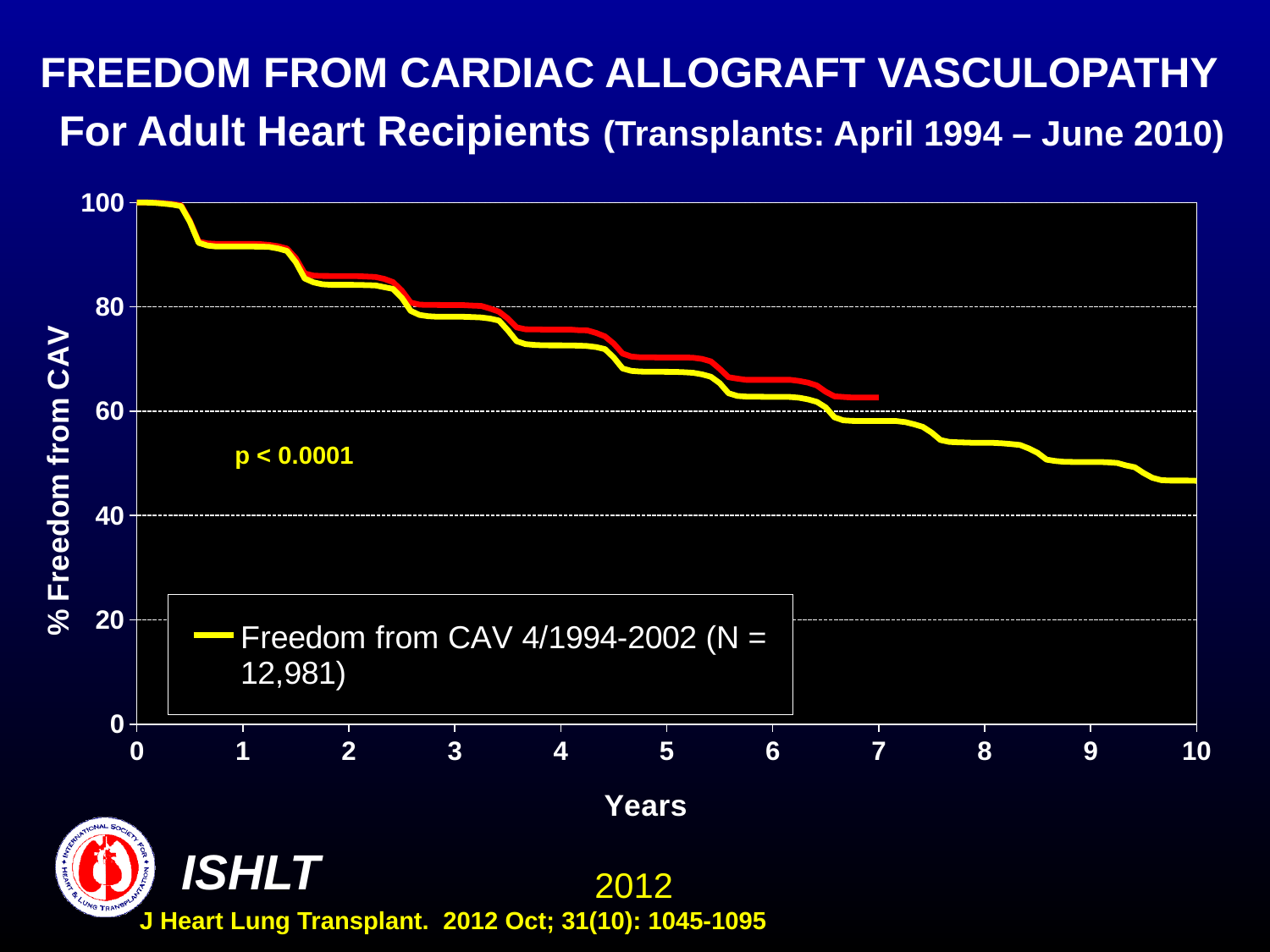
Is the value of the yellow line at 5 years greater or less than 60? greater What kind of chart is shown on the slide? line chart How many series does the legend list? 1 At 6 years, which line is higher, the red line or the yellow line? red line Is the value of the red line at 5 years greater or less than 60? greater What is the legend entry for the yellow line? Freedom from CAV 4/1994-2002 (N = 12,981) What is the highest value shown on the x axis? 10 Is the value of the yellow line at 10 years greater or less than 40? greater Does the yellow line rise or fall as the years increase along the x axis? fall What is the label of the y axis? % Freedom from CAV